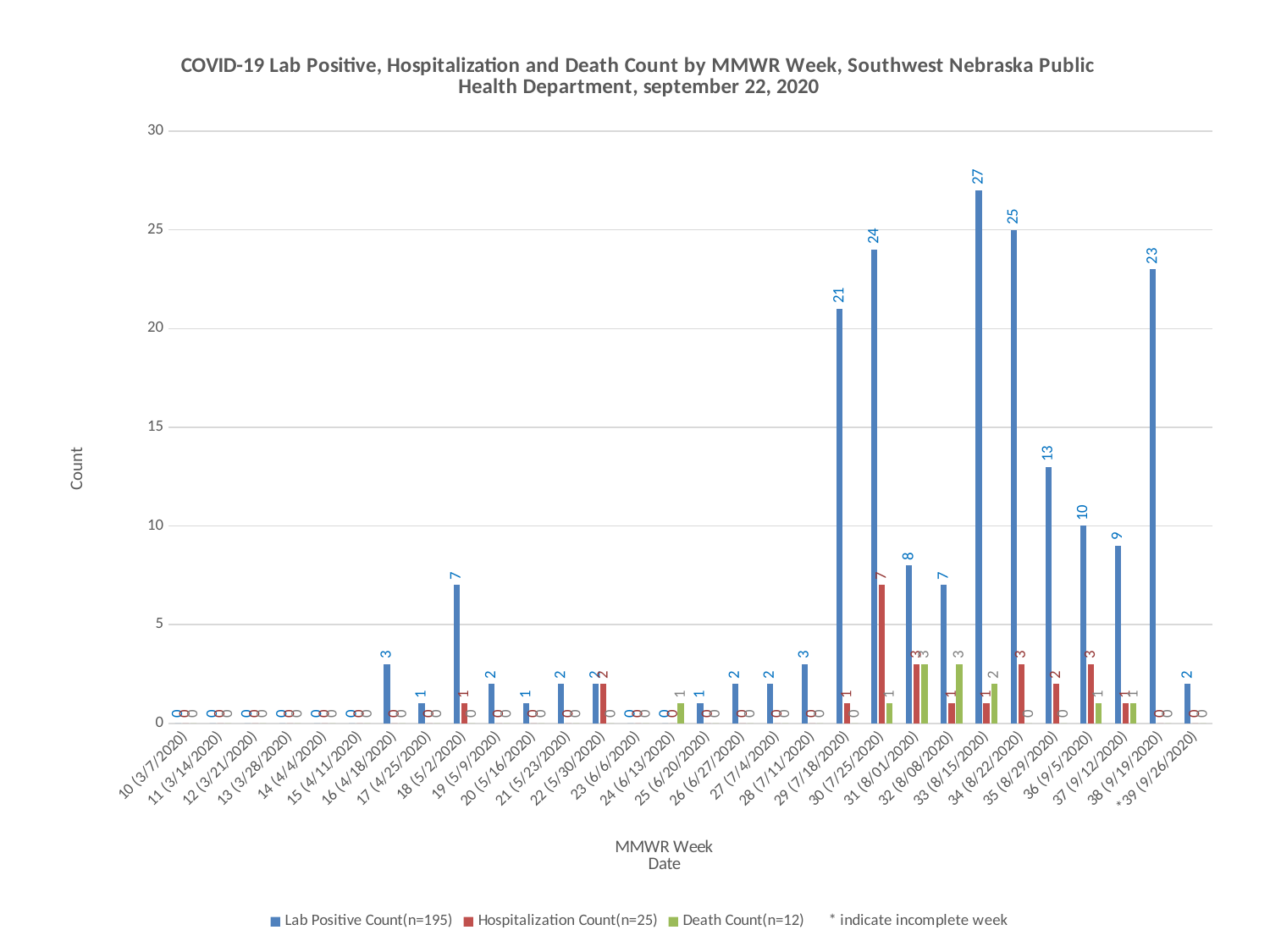
What type of chart is shown on the slide? bar chart Which MMWR week has the highest Lab Positive Count? 33 (8/15/2020) According to the legend, what is the total n for the Lab Positive Count series? 195 What is the difference between the Lab Positive Count for week 33 (8/15/2020) and week 34 (8/22/2020)? 2 What is the Death Count for MMWR week 31 (8/01/2020)? 3 Which is larger, the Lab Positive Count for week 29 (7/18/2020) or for week 38 (9/19/2020)? week 38 (9/19/2020) What is the Lab Positive Count for MMWR week 33 (8/15/2020)? 27 Is the Lab Positive Count for week 30 (7/25/2020) greater or less than 20? greater How many MMWR weeks are shown on the x axis? 30 How many series does the legend list? 3 Which MMWR week has the highest Hospitalization Count? 30 (7/25/2020) What is the Hospitalization Count for MMWR week 30 (7/25/2020)? 7